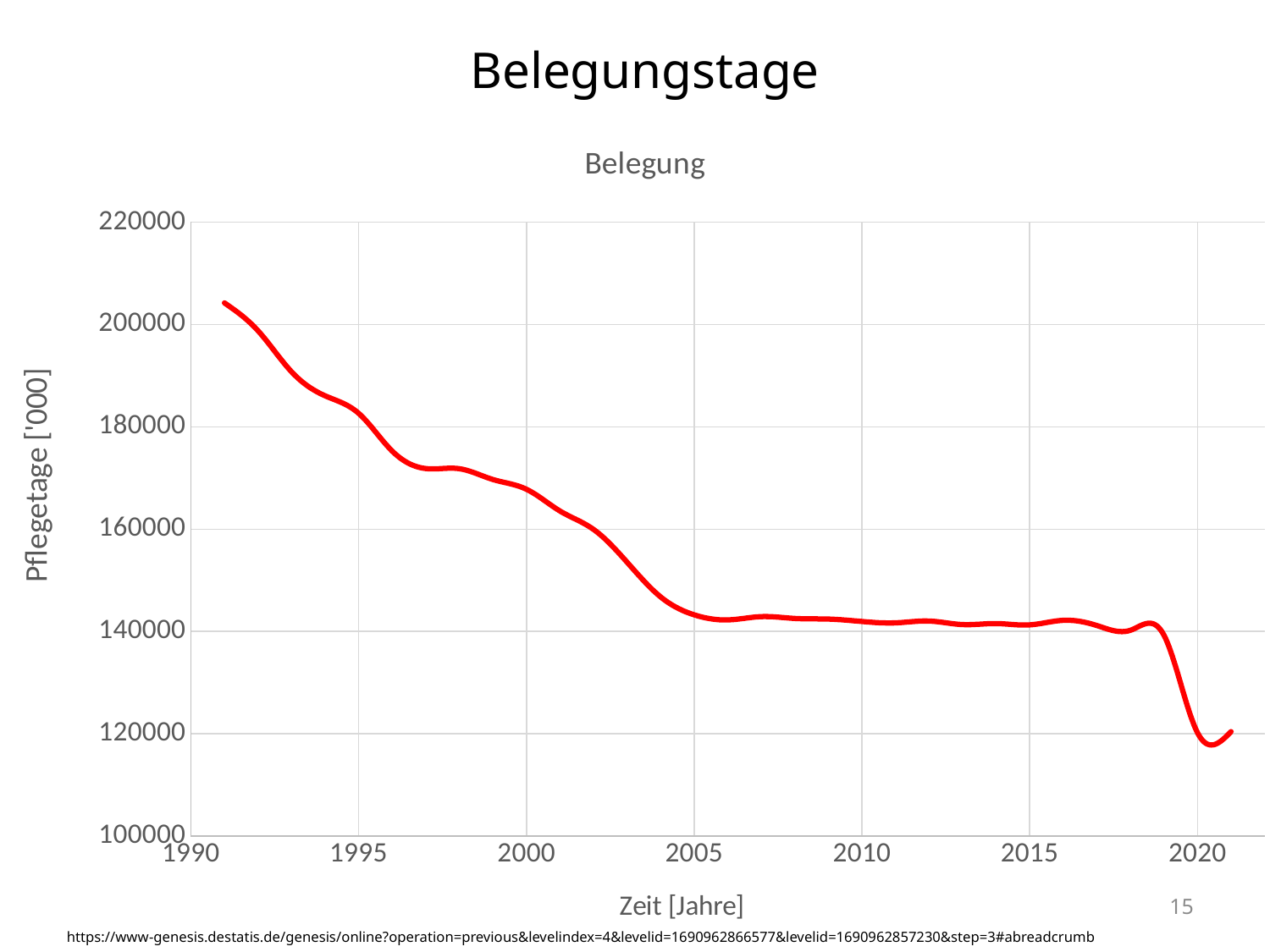
What is the title of the chart? Belegung Is the value for 1991 greater or less than 200000? greater Do the values generally rise or fall from 1991 to 2021 along the x axis? fall Is the value for 2010 greater or less than 140000? greater What kind of chart is shown on the slide? line chart Is the value for 2000 greater or less than 160000? greater Which year has the lowest value on the chart? 2020 What is the label of the y axis? Pflegetage ['000] Which year has the highest value on the chart? 1991 Which is larger, the value for 1995 or the value for 2015? 1995